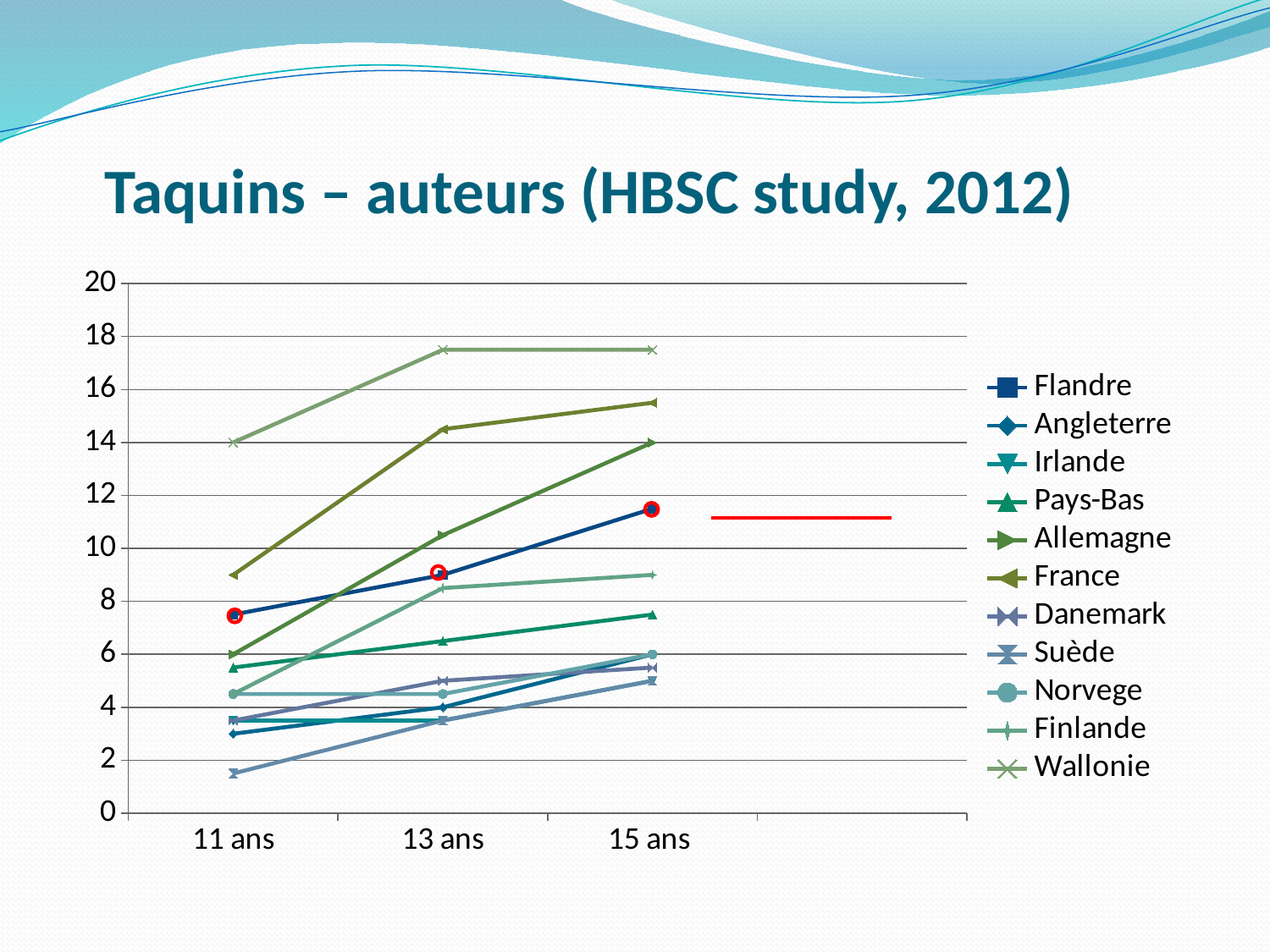
At 15 ans, which is larger: Allemagne or Flandre? Allemagne What is the title of the slide? Taquins – auteurs (HBSC study, 2012) How many age categories are shown on the x axis? 3 How many series does the legend list? 11 Which series has the highest value at 15 ans? Wallonie Which series has the lowest value at 11 ans? Suède At 15 ans, which is larger: Finlande or Pays-Bas? Finlande Does the value for Flandre rise or fall from 11 ans to 15 ans? rise Is the value for Suède at 11 ans greater or less than 2? less What kind of chart is shown on the slide? line chart Is the value for Wallonie at 13 ans greater or less than 16? greater Is the value for France at 15 ans greater or less than 14? greater